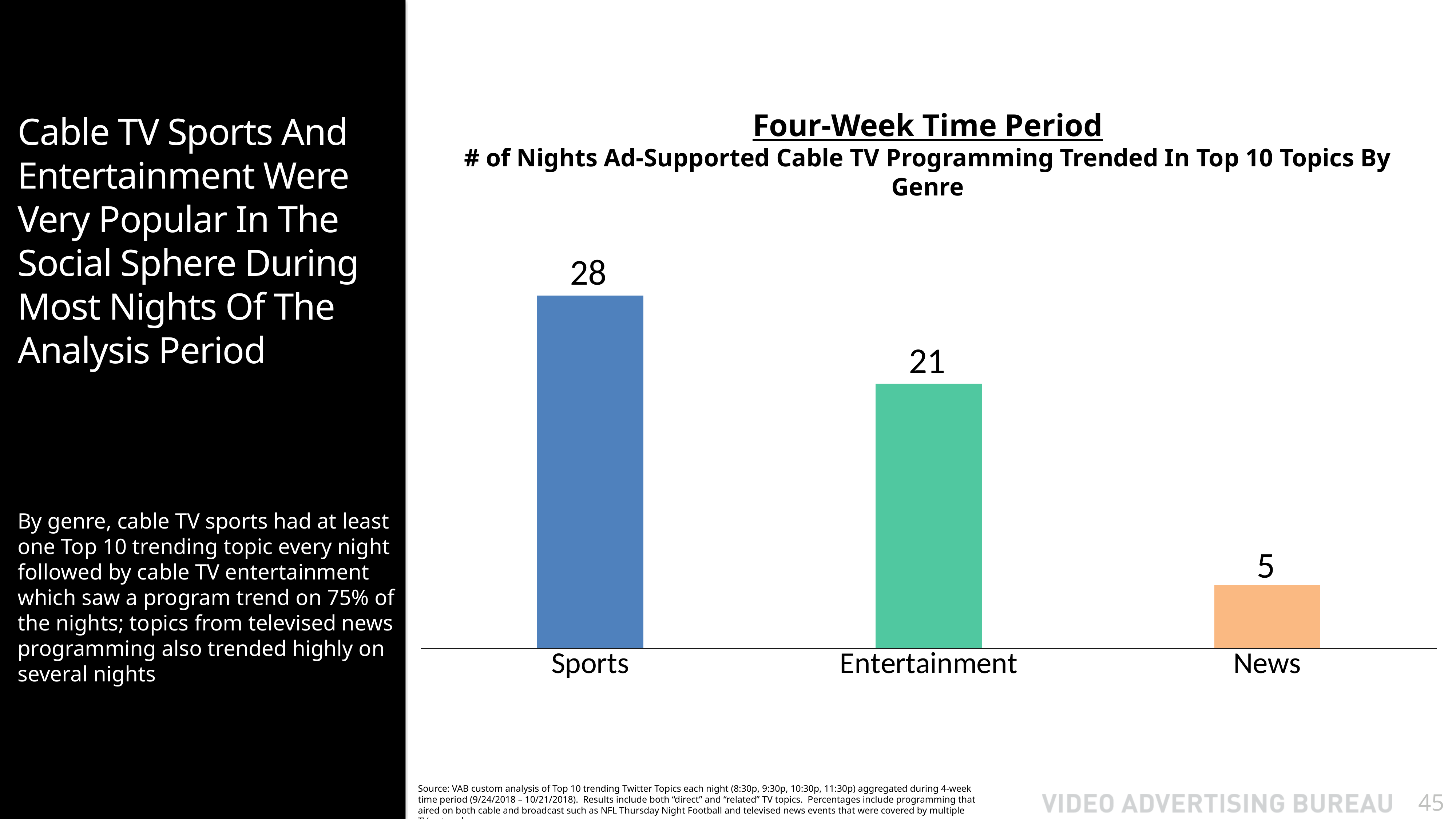
Which genre has the highest number of nights? Sports What is the underlined title of the chart? Four-Week Time Period What is the value for Entertainment? 21 What is the difference between the values for Sports and Entertainment? 7 What is the value for News? 5 What is the value for Sports? 28 Which is larger, the value for Entertainment or the value for News? Entertainment What kind of chart is shown on the slide? Bar chart What is the difference between the values for Entertainment and News? 16 How many genres are shown in the chart? 3 Which genre has the lowest number of nights? News Do the values rise or fall from left to right across the genres? Fall